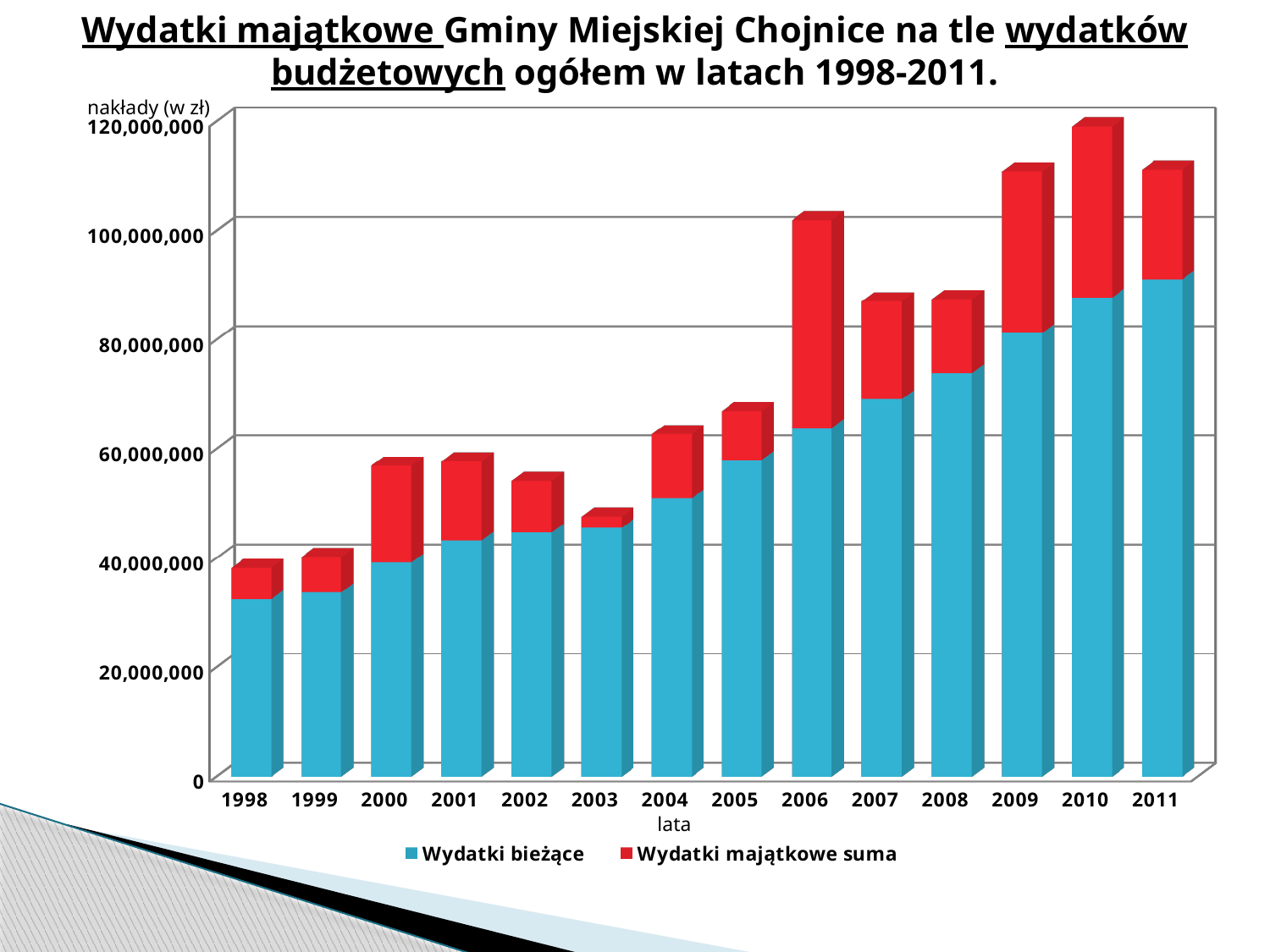
What kind of chart is shown on the slide? stacked bar chart Which series is shown in red in the chart? Wydatki majątkowe suma How many series does the legend list? 2 Which year has the lowest total bar? 1998 Which is larger, the Wydatki majątkowe suma segment for 2006 or for 2007? 2006 Which year has the highest total bar? 2010 How many years are shown on the x axis of the chart? 14 Is the Wydatki bieżące value for 2011 greater or less than 80,000,000? greater Do the total bar values generally rise or fall from 1998 to 2011? rise Is the total value for 2010 greater or less than 100,000,000? greater Is the total value for 2003 greater or less than 60,000,000? less